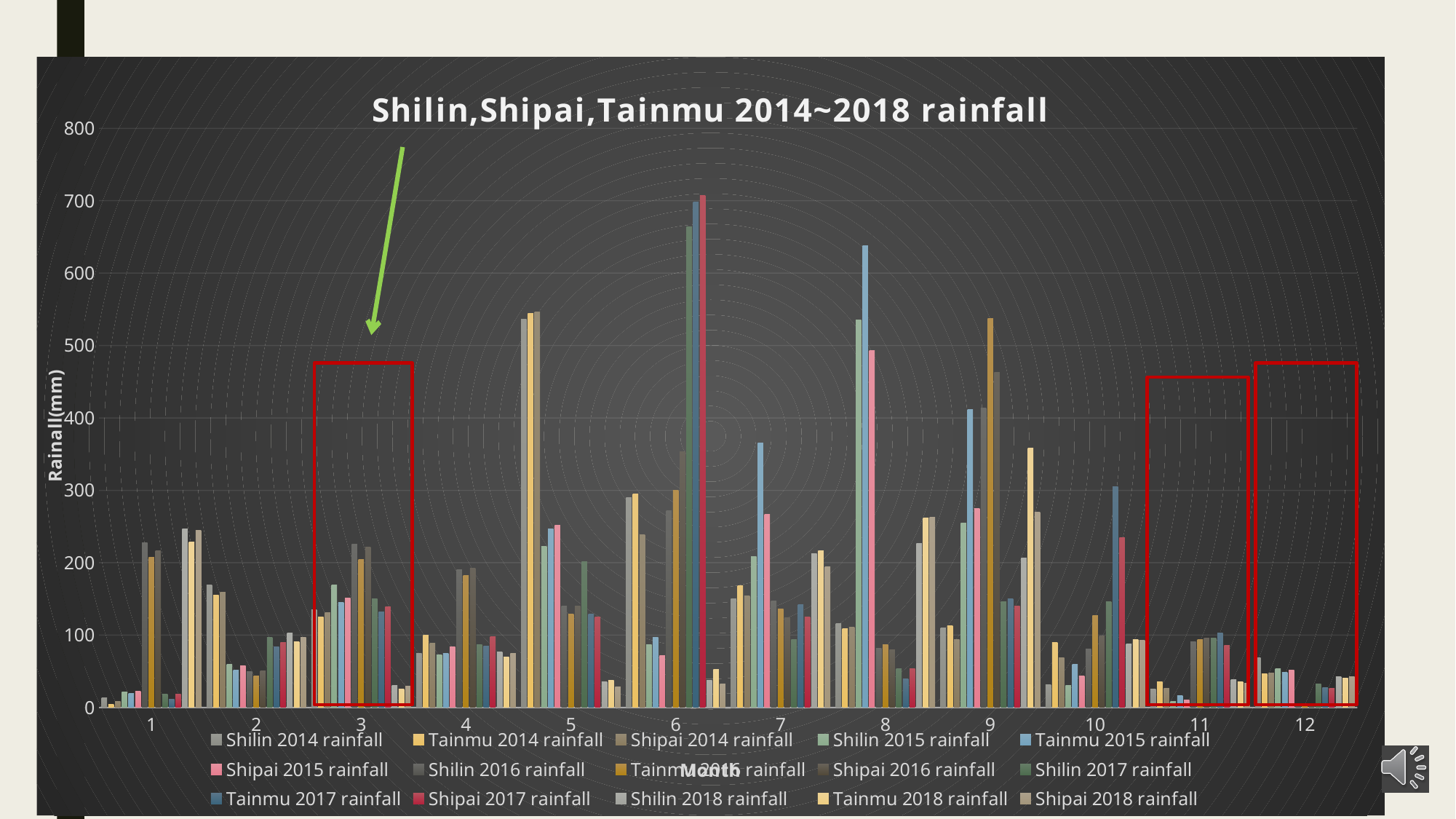
Is the tallest bar in month 11 greater or less than 200? less Is the tallest bar in month 1 greater or less than 300? less Which month has the taller tallest bar, month 6 or month 12? 6 Is the tallest bar in month 8 greater or less than 600? greater Which month contains the tallest bar on the chart? 6 How many months are shown along the x axis of the chart? 12 Which months on the chart are outlined with red boxes? 3, 11 and 12 What kind of chart is shown on the slide? bar chart How many series does the chart's legend list? 15 What is the title of the chart? Shilin,Shipai,Tainmu 2014~2018 rainfall